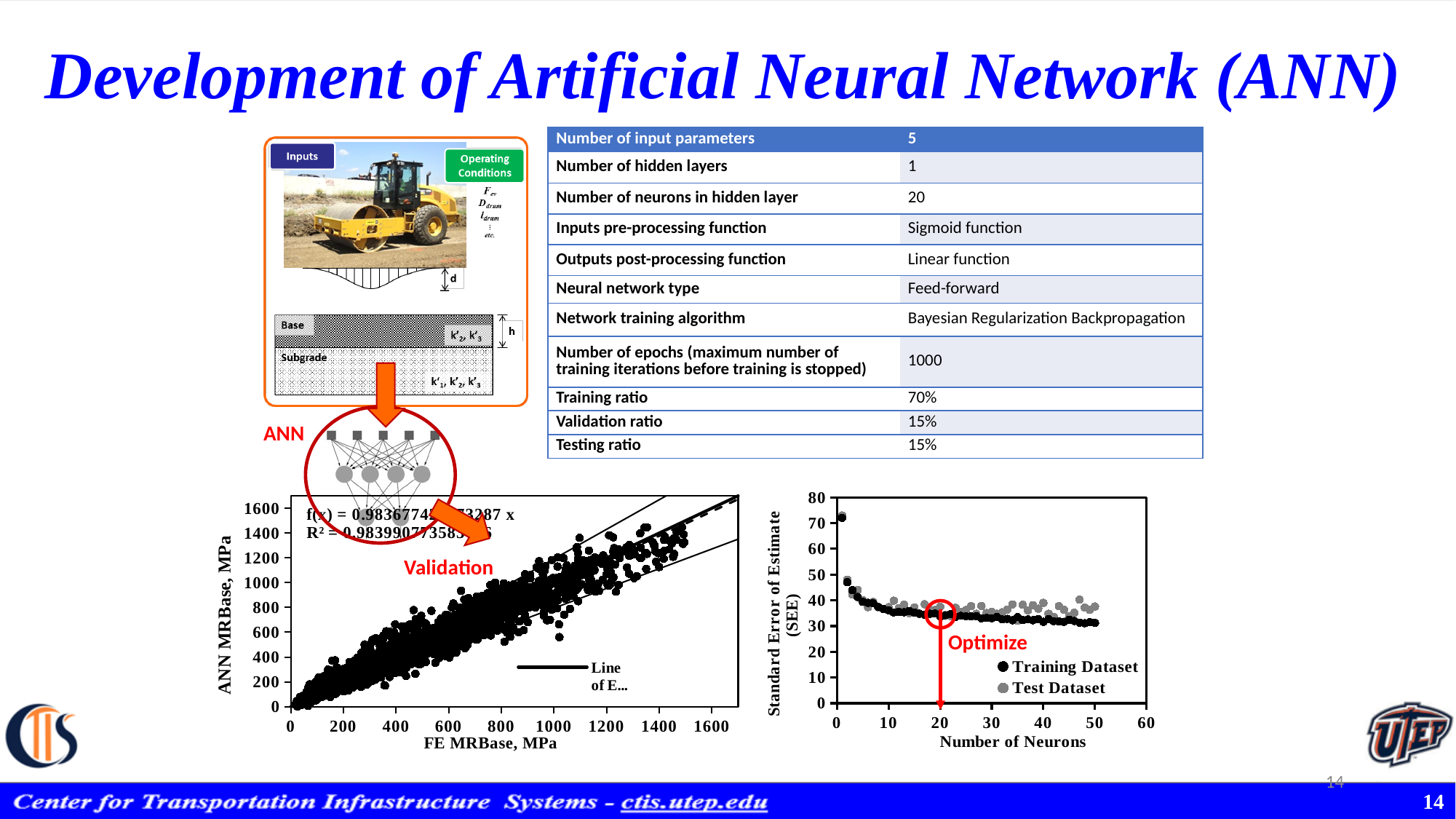
In the chart on the right, what is the title of the x axis? Number of Neurons In the chart on the right, what are the two series named in the legend? Training Dataset and Test Dataset In the chart on the right, how many series does the legend list? 2 What kind of chart is the chart on the left, with FE MRBase, MPa on the x axis? scatter chart In the chart on the right, does the Standard Error of Estimate rise or fall as the number of neurons increases? fall In the chart on the left, what is the maximum value shown on the x axis? 1600 In the chart on the right, which series generally has the higher SEE values at larger numbers of neurons, Training Dataset or Test Dataset? Test Dataset What kind of chart is the chart on the right, with Number of Neurons on the x axis? scatter chart In the chart on the left, do the ANN MRBase values rise or fall as FE MRBase increases? rise In the chart on the right, is the Training Dataset value at 50 neurons greater or less than 40? less In the chart on the right, is the Training Dataset value at 1 neuron greater or less than 60? greater